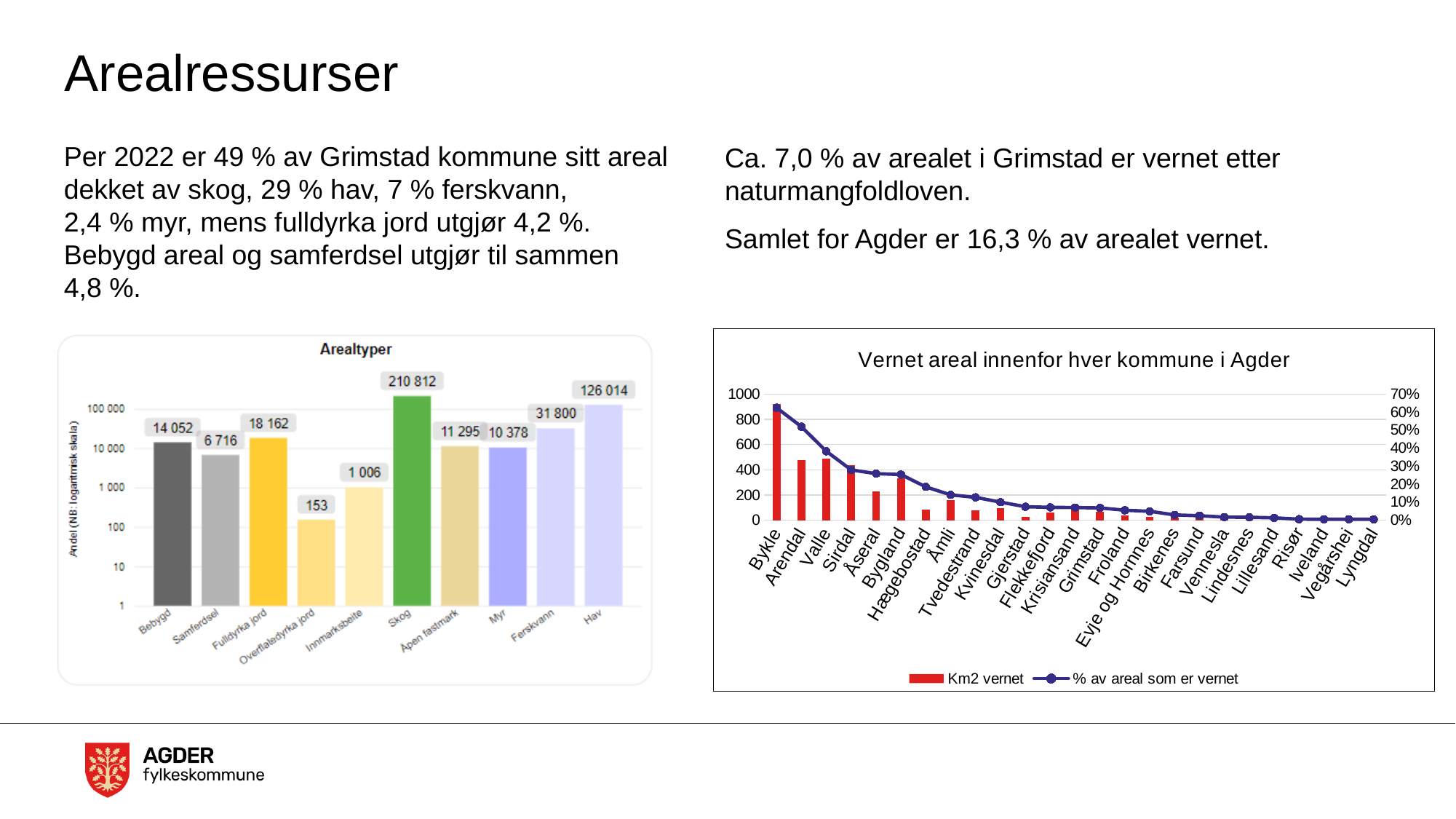
In the chart 'Vernet areal innenfor hver kommune i Agder', which municipality has the highest Km2 vernet? Bykle In the Arealtyper chart, what is the difference between the values for Bebygd and Samferdsel? 7 336 How many series does the legend of the chart 'Vernet areal innenfor hver kommune i Agder' list? 2 In the Arealtyper chart, what is the value for Ferskvann? 31 800 What kind of chart is the Arealtyper chart? Bar chart In the Arealtyper chart, which is larger, Myr or Åpen fastmark? Åpen fastmark In the Arealtyper chart, which category has the lowest value? Overflatedyrka jord In the Arealtyper chart, which category has the highest value? Skog In the chart 'Vernet areal innenfor hver kommune i Agder', is the Km2 vernet value for Arendal greater or less than 600? less How many categories are shown in the Arealtyper chart? 10 In the Arealtyper chart, what is the value for Overflatedyrka jord? 153 In the Arealtyper chart, what is the value for Skog? 210 812